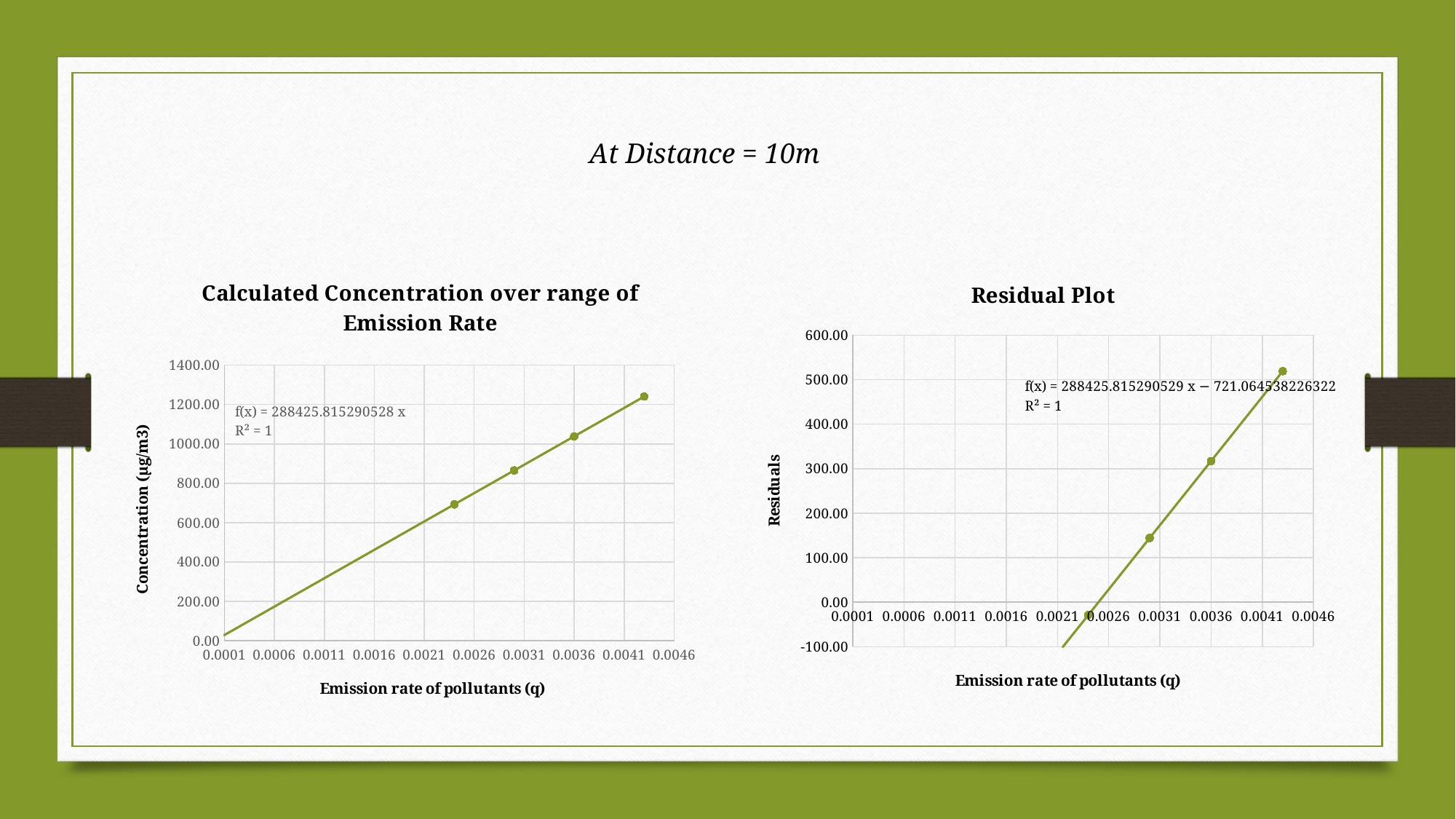
In the 'Residual Plot' chart, is the residual of the highest plotted point greater or less than 500.00? greater What kind of chart is the 'Residual Plot' chart? scatter chart with a trendline In the 'Calculated Concentration over range of Emission Rate' chart, how many data points are plotted? 5 In the 'Calculated Concentration over range of Emission Rate' chart, is the concentration of the lowest plotted point greater or less than 800.00? less In the 'Residual Plot' chart, how many data points are plotted? 4 What is the y-axis label of the 'Calculated Concentration over range of Emission Rate' chart? Concentration (µg/m3) What kind of chart is the 'Calculated Concentration over range of Emission Rate' chart? scatter chart with a trendline What R² value is shown on the 'Residual Plot' chart? R² = 1 In the 'Calculated Concentration over range of Emission Rate' chart, is the concentration of the highest plotted point greater or less than 1200.00? greater In the 'Calculated Concentration over range of Emission Rate' chart, do the concentration values rise or fall as the emission rate increases? rise In the 'Residual Plot' chart, do the residuals rise or fall as the emission rate increases? rise